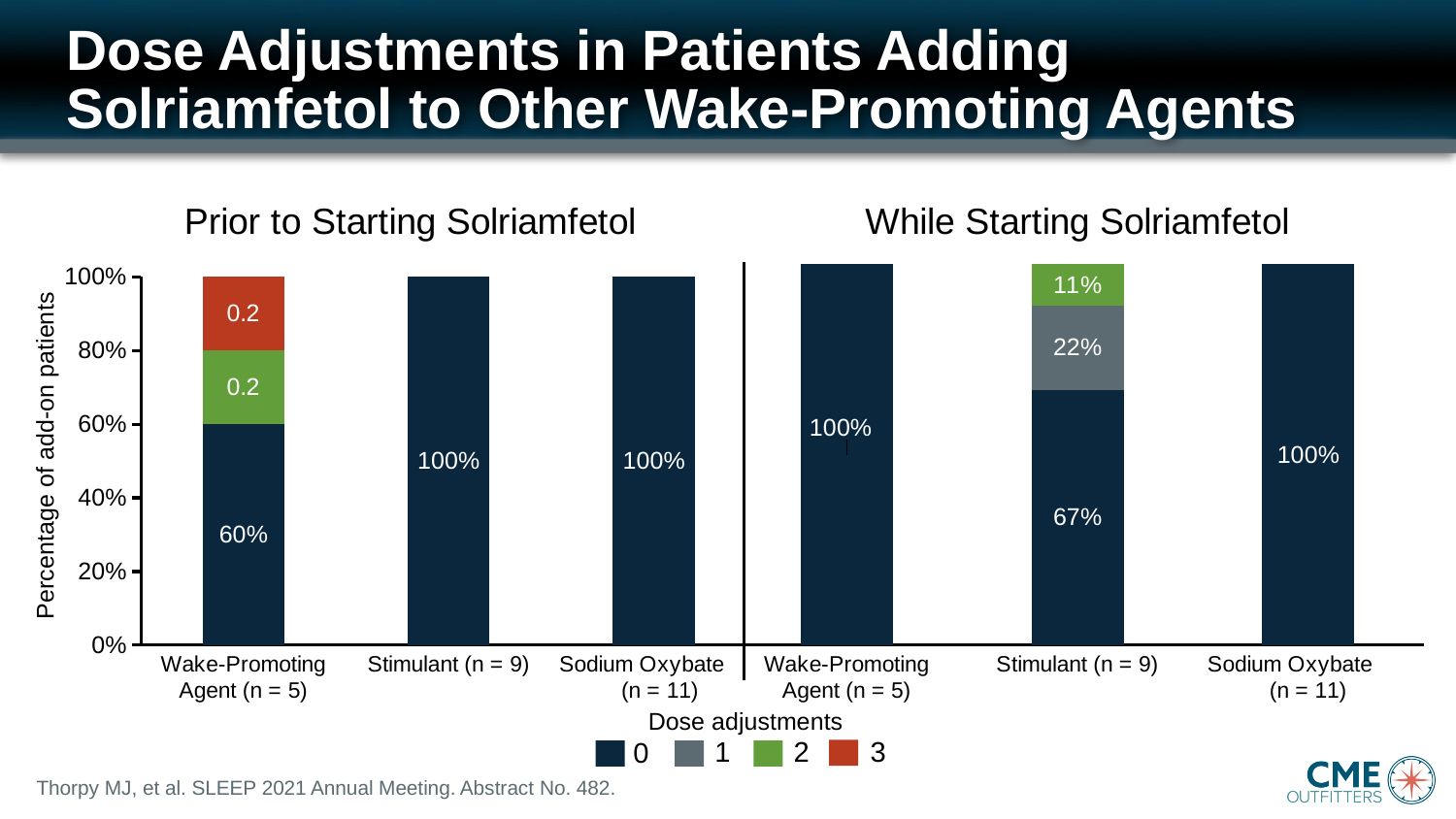
What kind of chart is shown on the slide? Stacked bar chart In the 'Prior to Starting Solriamfetol' panel, what percentage of Wake-Promoting Agent (n = 5) patients had 0 dose adjustments? 60% In the 'While Starting Solriamfetol' panel, which is larger for Stimulant (n = 9): the share with 1 dose adjustment or the share with 2 dose adjustments? 1 dose adjustment How many dose adjustment series does the legend list? 4 In the 'While Starting Solriamfetol' panel, what percentage of Stimulant (n = 9) patients had 1 dose adjustment? 22% In the 'While Starting Solriamfetol' panel, what percentage of Stimulant (n = 9) patients had 2 dose adjustments? 11% In the 'Prior to Starting Solriamfetol' panel, what value is labelled on the 3 dose adjustments segment for Wake-Promoting Agent (n = 5)? 0.2 In the 'While Starting Solriamfetol' panel, what is the difference between the 0 and 1 dose adjustment percentages for Stimulant (n = 9)? 45% In the 'While Starting Solriamfetol' panel, what percentage of Sodium Oxybate (n = 11) patients had 0 dose adjustments? 100% In the 'While Starting Solriamfetol' panel, what percentage of Stimulant (n = 9) patients had 0 dose adjustments? 67% What is the label of the y axis? Percentage of add-on patients How many categories are shown on the x axis across both panels? 6